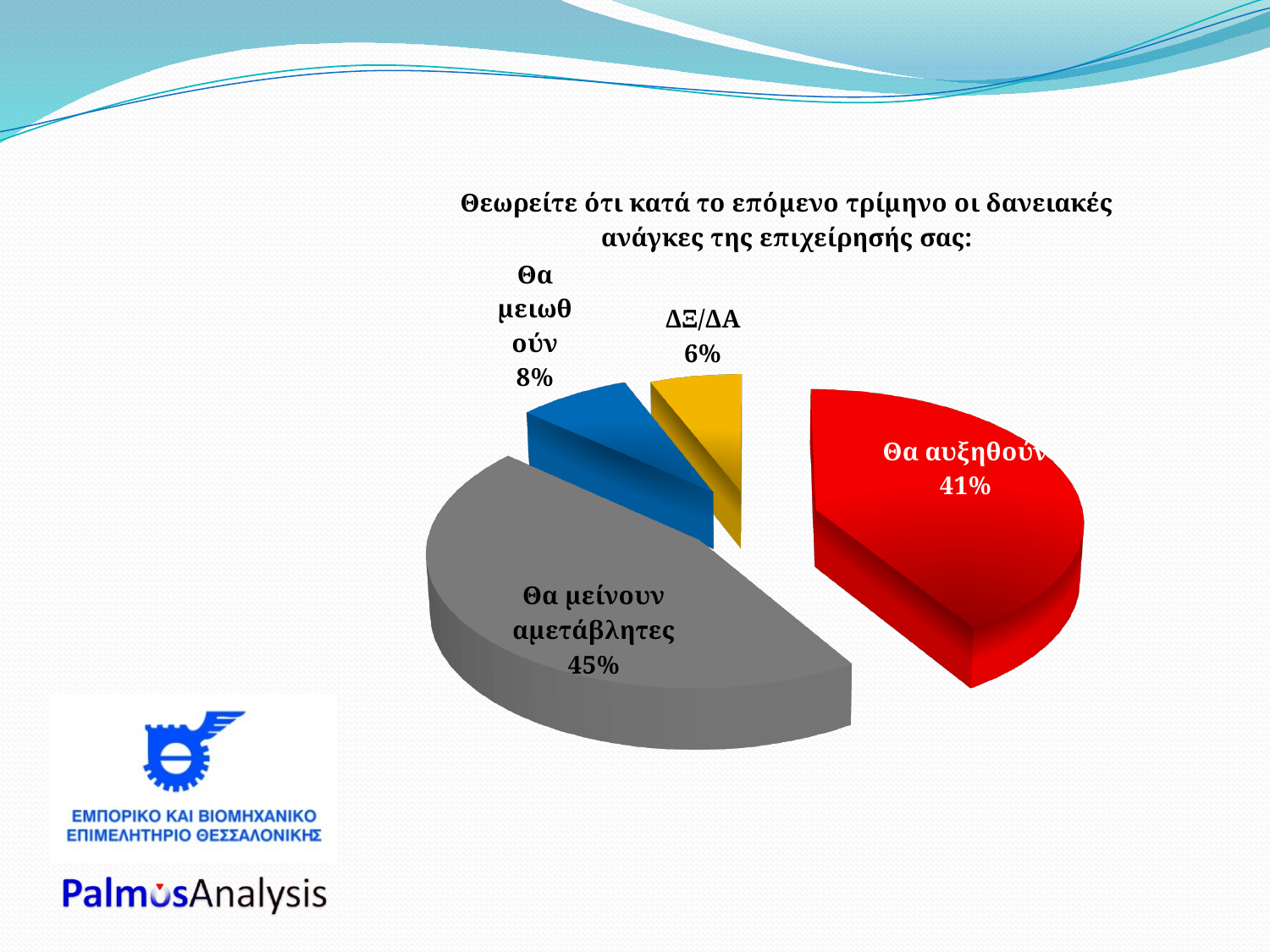
What kind of chart is shown on the slide? Pie chart What percentage of respondents answered "ΔΞ/ΔΑ"? 6% How many slices does the pie chart have? 4 What is the difference in percentage points between "Θα μείνουν αμετάβλητες" and "Θα αυξηθούν"? 4 percentage points What percentage of respondents answered "Θα μειωθούν"? 8% Which response has the largest share of the pie? Θα μείνουν αμετάβλητες What percentage of respondents answered "Θα αυξηθούν"? 41% What is the title of the chart? Θεωρείτε ότι κατά το επόμενο τρίμηνο οι δανειακές ανάγκες της επιχείρησής σας: What percentage of respondents answered "Θα μείνουν αμετάβλητες"? 45% Which response has the smallest share of the pie? ΔΞ/ΔΑ What colour is the slice for "Θα αυξηθούν"? Red Which is larger: the share for "Θα μειωθούν" or the share for "ΔΞ/ΔΑ"? Θα μειωθούν